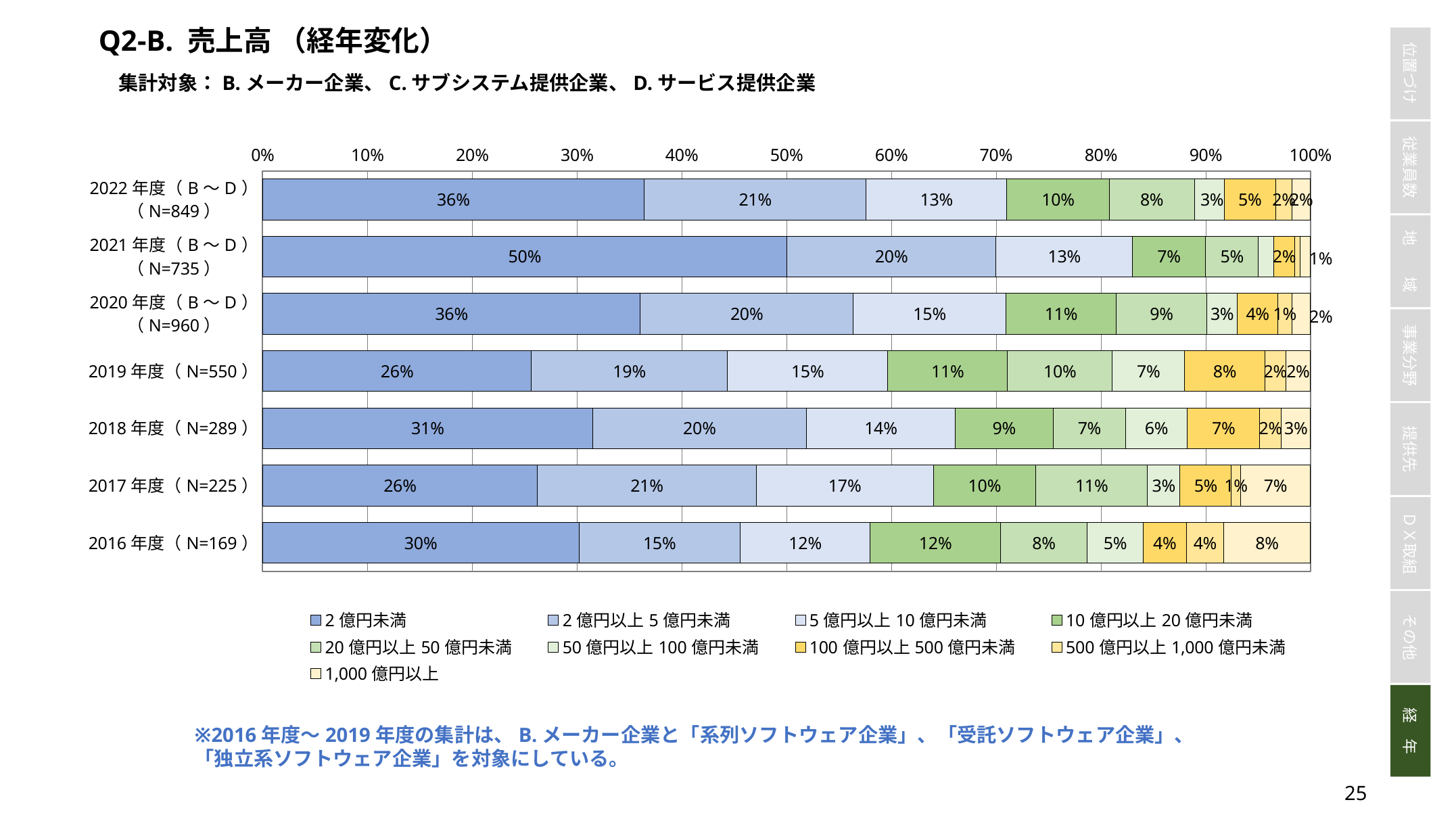
How many fiscal years (bars) are shown in the chart? 7 What share of companies in 2019年度 (N=550) had revenue of 100億円以上500億円未満? 8% How many revenue categories does the legend list? 9 Which fiscal year has the lowest share of companies with revenue of 2億円以上5億円未満? 2016年度 (N=169) Which is larger: the 5億円以上10億円未満 share in 2017年度 or in 2016年度? 2017年度 What is the difference between the 2億円未満 share in 2021年度 and in 2022年度? 14 percentage points Which fiscal year has the highest share of companies with revenue of 2億円未満? 2021年度 (N=735) What kind of chart is shown on the slide? Stacked bar chart What is the title of the slide? Q2-B. 売上高（経年変化） What share of companies in 2016年度 (N=169) had revenue of 1,000億円以上? 8% What is the sample size (N) for 2020年度? 960 What share of companies in 2021年度 (N=735) had revenue of 2億円未満? 50%